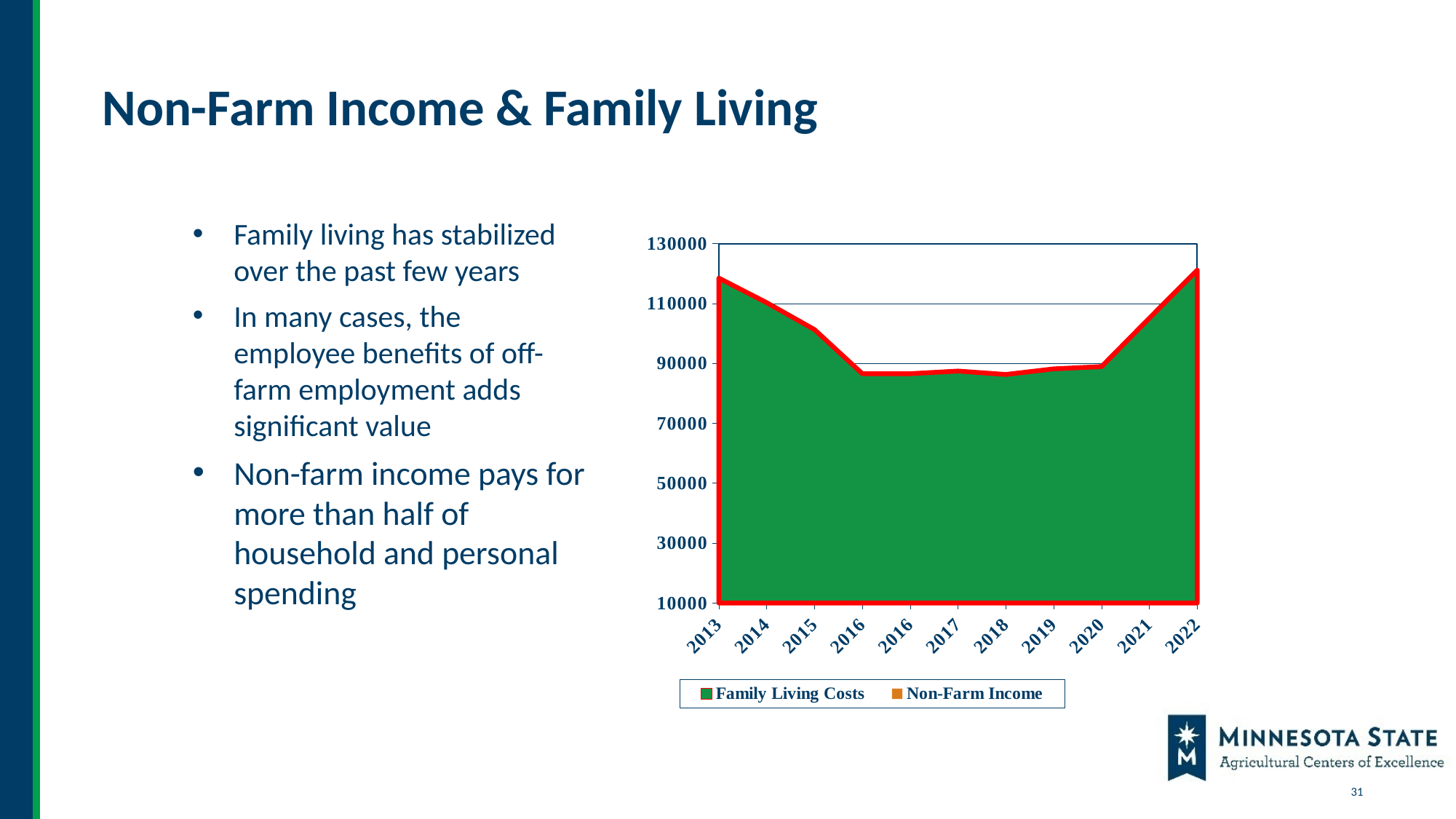
Is the value for Family Living Costs in 2022 greater or less than 110000? greater Do Family Living Costs rise or fall from 2013 to 2016? fall Is the value for Family Living Costs in 2015 greater or less than 90000? greater Is the value for Family Living Costs in 2013 greater or less than 110000? greater Which year has the larger Family Living Costs value, 2013 or 2018? 2013 Do Family Living Costs rise or fall from 2020 to 2022? rise What are the two series named in the chart legend? Family Living Costs and Non-Farm Income In which year does Family Living Costs reach its highest value? 2022 How many year labels are shown along the x axis of the chart? 11 How many series does the chart legend list? 2 What type of chart is shown on the slide? Area chart